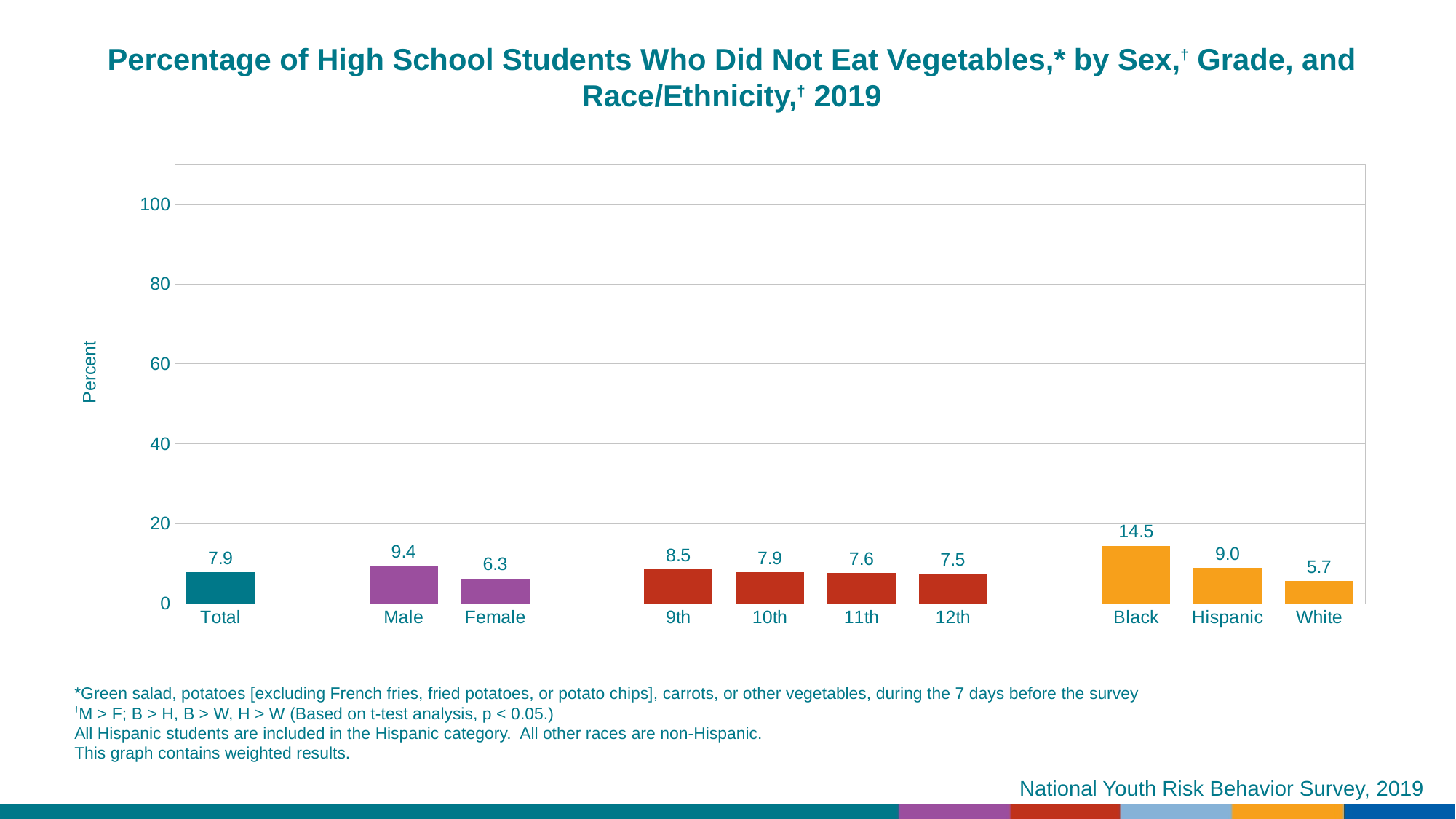
What is the difference between the Male and Female values? 3.1 What is the value for 10th grade students? 7.9 Which category has the lowest percentage? White What percentage of Black students did not eat vegetables? 14.5 Do the values rise or fall across the grade categories from 9th to 12th? fall What kind of chart is this? bar chart What is the difference between the Black and Hispanic values? 5.5 Which is larger, the value for 9th grade or 12th grade? 9th Which category has the highest percentage? Black What is the value for Female students? 6.3 How many categories are shown on the x axis? 10 Is the value for Black students greater or less than 20? less